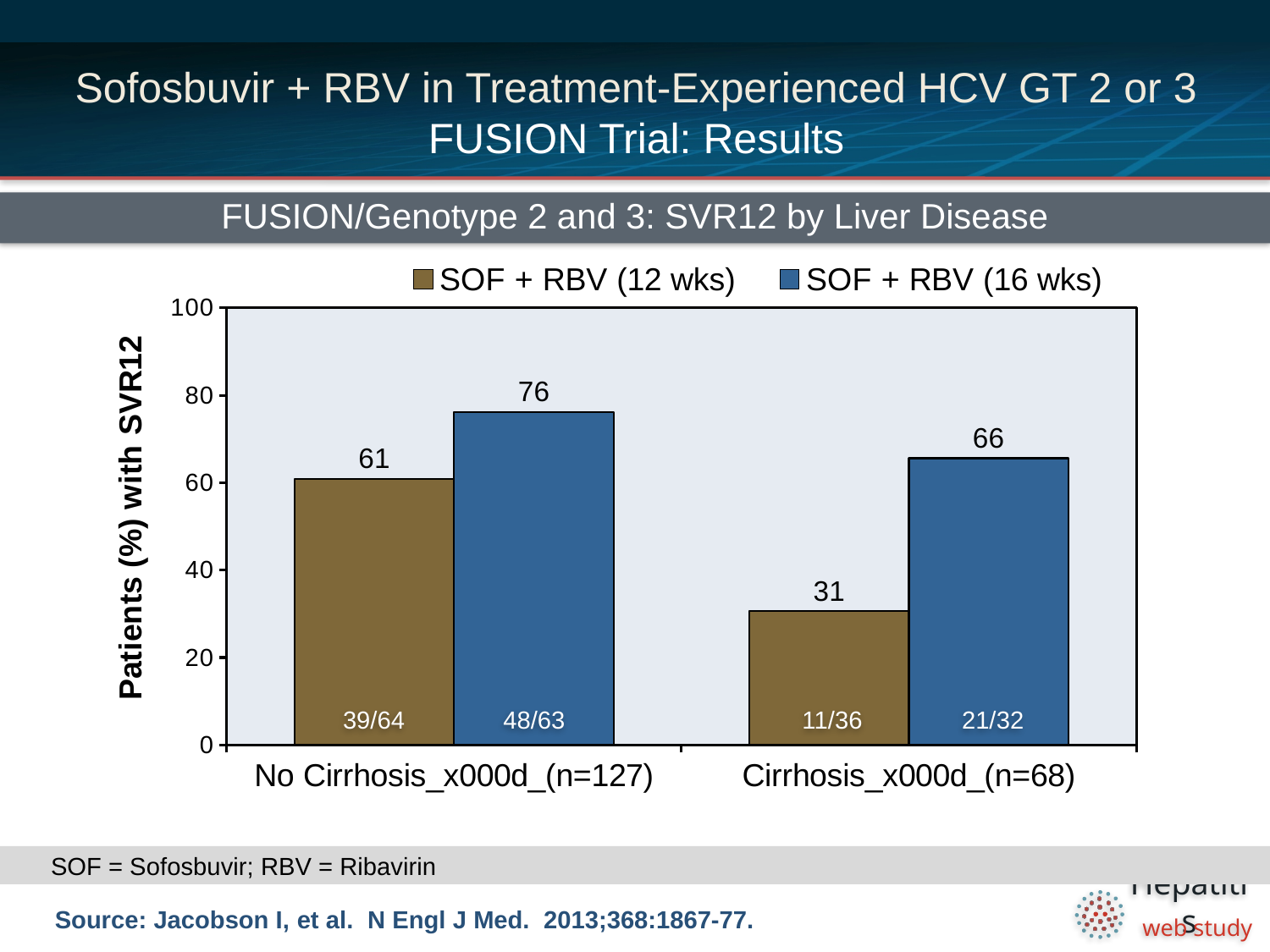
What is the difference in SVR12 rate between the 16-week and 12-week arms in the No Cirrhosis group? 15 How many patient groups are shown on the x axis? 2 What is the difference in SVR12 rate between the 16-week and 12-week arms in the Cirrhosis group? 35 What kind of chart is shown? Bar chart Which is larger: the SVR12 rate for SOF + RBV (12 wks) in No Cirrhosis or SOF + RBV (16 wks) in Cirrhosis? SOF + RBV (16 wks) in Cirrhosis What is the SVR12 rate for SOF + RBV (16 wks) in the Cirrhosis group? 66 How many series does the legend list? 2 What is the SVR12 rate for SOF + RBV (12 wks) in the No Cirrhosis group? 61 Which bar shows the lowest SVR12 rate? SOF + RBV (12 wks), Cirrhosis Which bar shows the highest SVR12 rate? SOF + RBV (16 wks), No Cirrhosis What is the SVR12 rate for SOF + RBV (12 wks) in the Cirrhosis group? 31 What fraction of patients is printed on the SOF + RBV (16 wks) bar in the No Cirrhosis group? 48/63